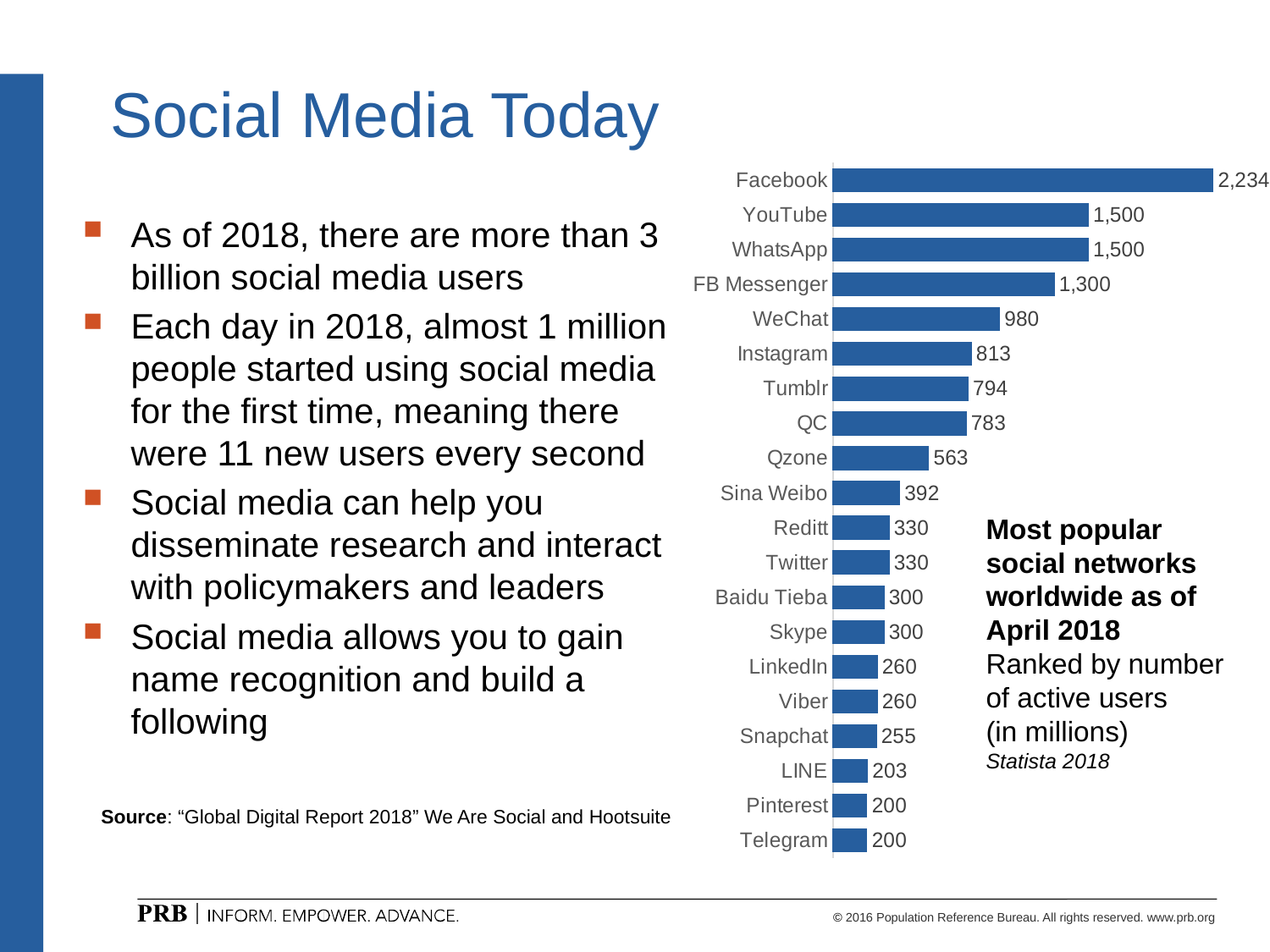
What is the value for Qzone? 563 What is the value for Snapchat? 255 What is the difference between the values for Instagram and Tumblr? 19 Which has a larger value, Sina Weibo or Qzone? Qzone What kind of chart is shown on the slide? Bar chart What is the difference between the values for Facebook and YouTube? 734 What is the title of the chart? Most popular social networks worldwide as of April 2018 What is the value for WeChat? 980 Which social network has the highest value? Facebook How many social networks are shown in the chart? 20 What is the value for Facebook? 2,234 Which has a larger value, FB Messenger or WeChat? FB Messenger